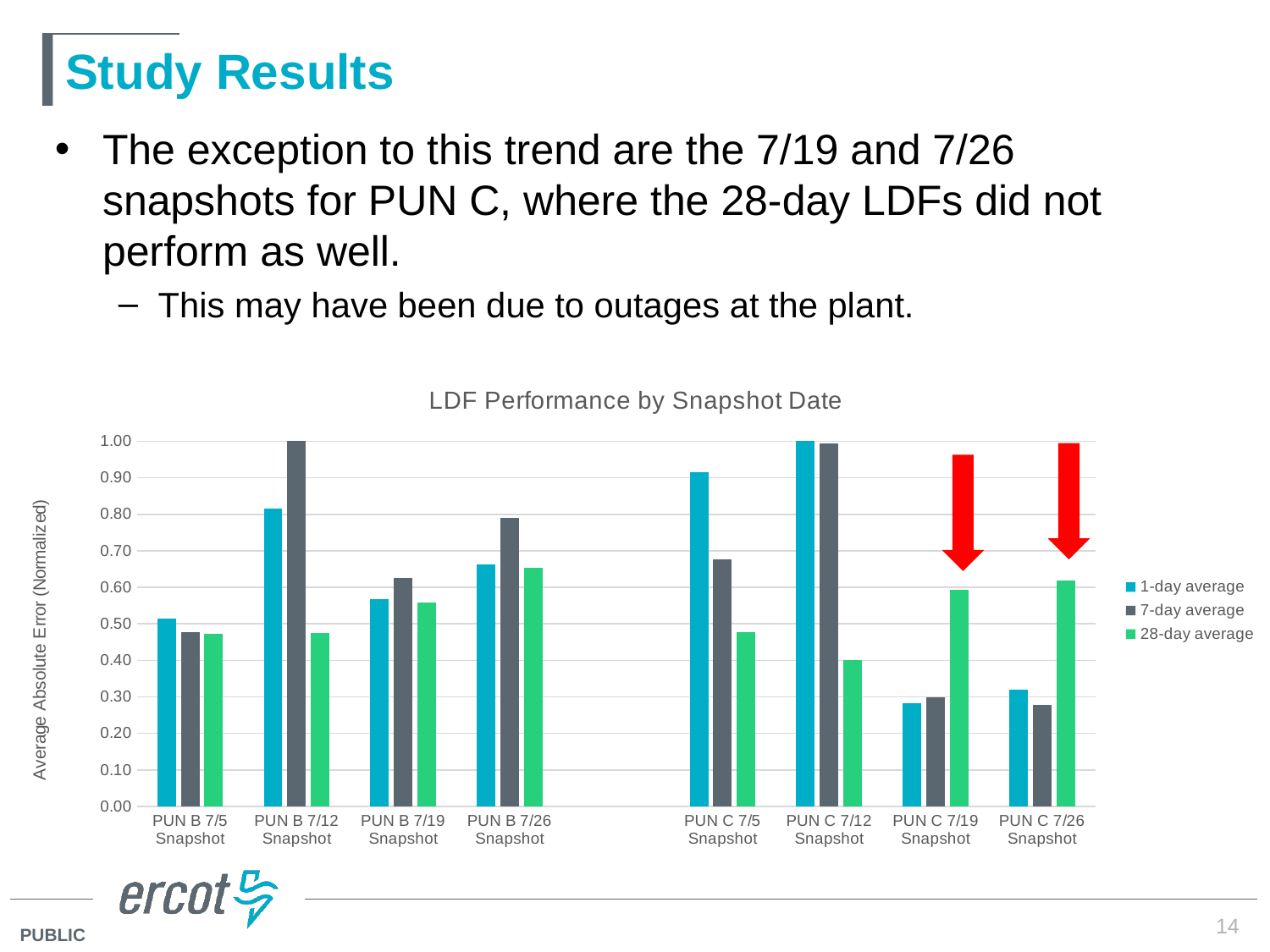
What is the 7-day average value for the PUN B 7/12 Snapshot? 1.00 For the PUN B 7/12 Snapshot, which is larger: the 1-day average or the 7-day average? 7-day average For the PUN C 7/19 Snapshot, which is larger: the 1-day average or the 28-day average? 28-day average Is the 28-day average value for the PUN B 7/12 Snapshot greater or less than 0.60? less Which snapshot has the highest 1-day average value? PUN C 7/12 Snapshot What is the label of the vertical axis of the chart? Average Absolute Error (Normalized) What type of chart is shown on the slide? bar chart How many series does the chart legend list? 3 Is the 1-day average value for the PUN C 7/19 Snapshot greater or less than 0.40? less What is the title of the chart? LDF Performance by Snapshot Date Is the 1-day average value for the PUN C 7/5 Snapshot greater or less than 0.80? greater How many snapshot categories are shown on the x axis of the chart? 8